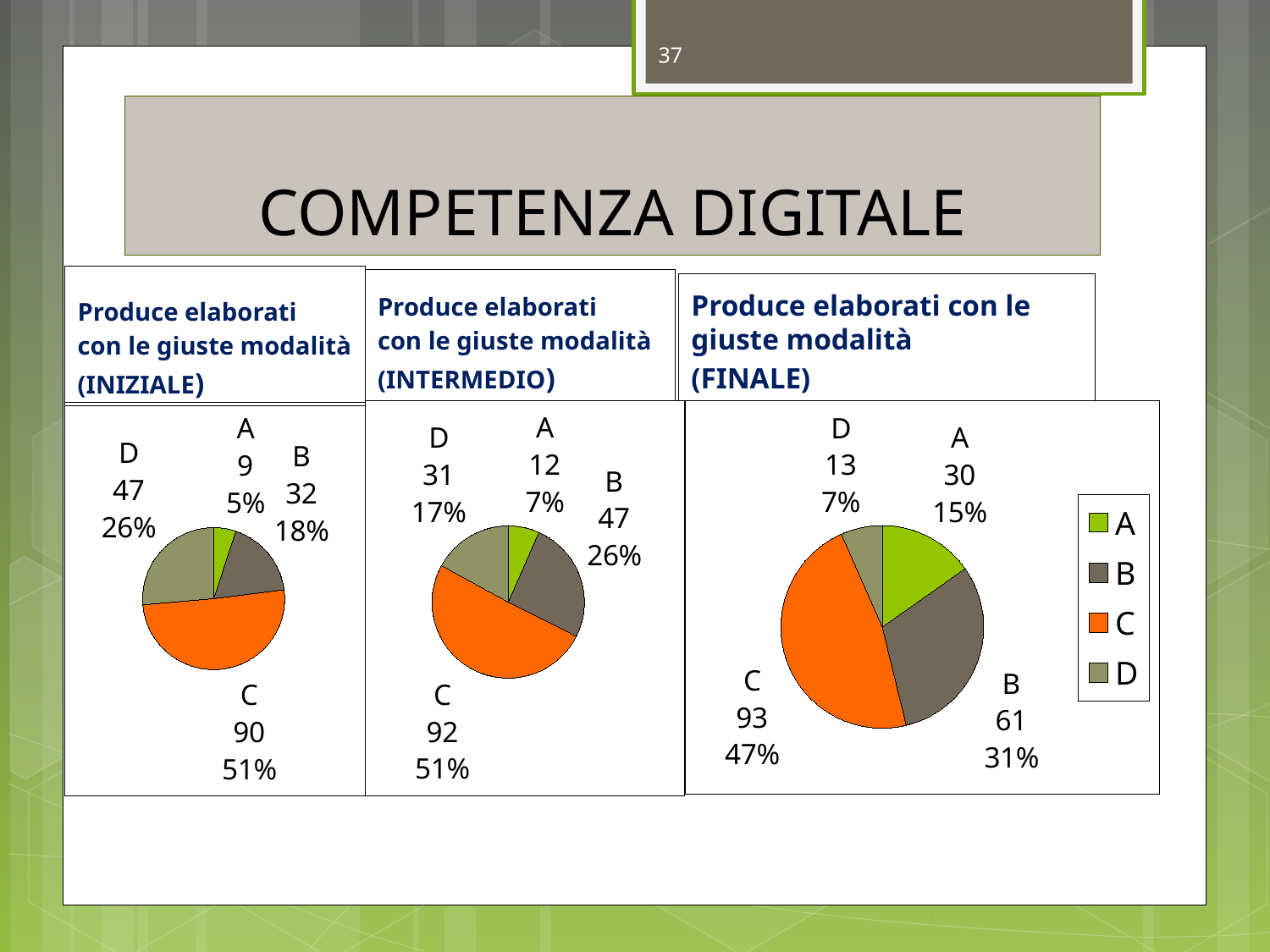
In the INIZIALE pie chart, which category has the smallest value? A In the FINALE pie chart, what is the value for category D? 13 In the INIZIALE pie chart, what percentage share does category D have? 26% In the FINALE pie chart, what percentage share does category B have? 31% How many categories does the legend on the right of the slide list? 4 What type of chart is used in the INTERMEDIO panel? Pie chart In the INIZIALE pie chart, what is the value for category C? 90 In the INTERMEDIO pie chart, what percentage share does category A have? 7% Which is larger: the value for A in the FINALE pie chart or the value for A in the INIZIALE pie chart? FINALE In the FINALE pie chart, what is the difference between the values for C and B? 32 In the INTERMEDIO pie chart, what is the value for category B? 47 In the INTERMEDIO pie chart, which category has the largest value? C